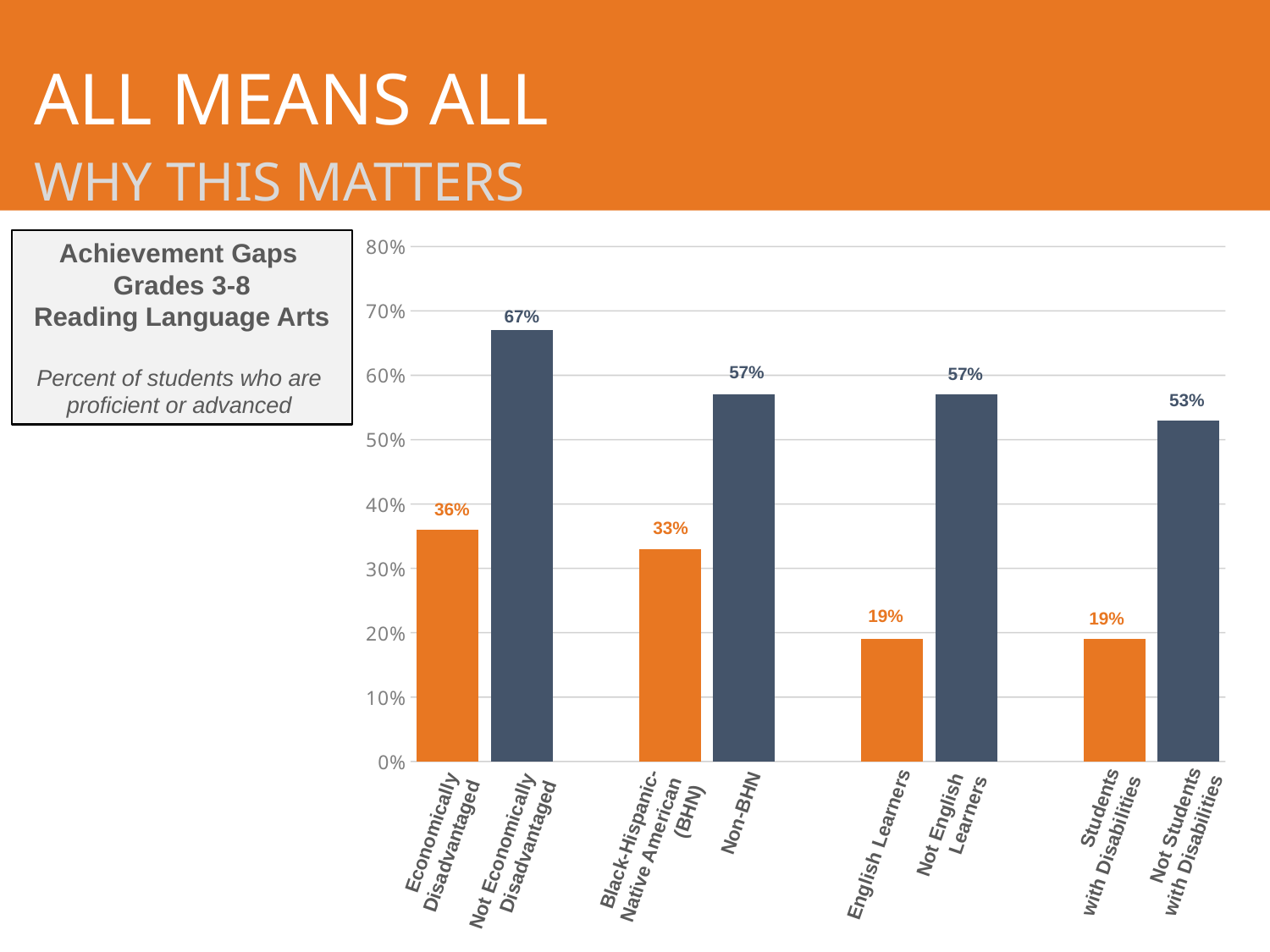
What kind of chart is shown on the slide? Bar chart Is the value for Non-BHN greater or less than 50%? greater How many bars are plotted on the chart? 8 What is the value shown for Not Economically Disadvantaged students? 67% Which is larger, the value for Students with Disabilities or the value for Not Students with Disabilities? Not Students with Disabilities Which category has the highest percentage of students proficient or advanced? Not Economically Disadvantaged What is the difference between the Non-BHN value and the Black-Hispanic-Native American (BHN) value? 24% What percent of English Learners are proficient or advanced? 19% What grades does the chart's title say the achievement gaps cover? Grades 3-8 What is the value for Not Students with Disabilities? 53% What is the difference between Not Economically Disadvantaged and Economically Disadvantaged? 31% What percent of Economically Disadvantaged students are proficient or advanced? 36%